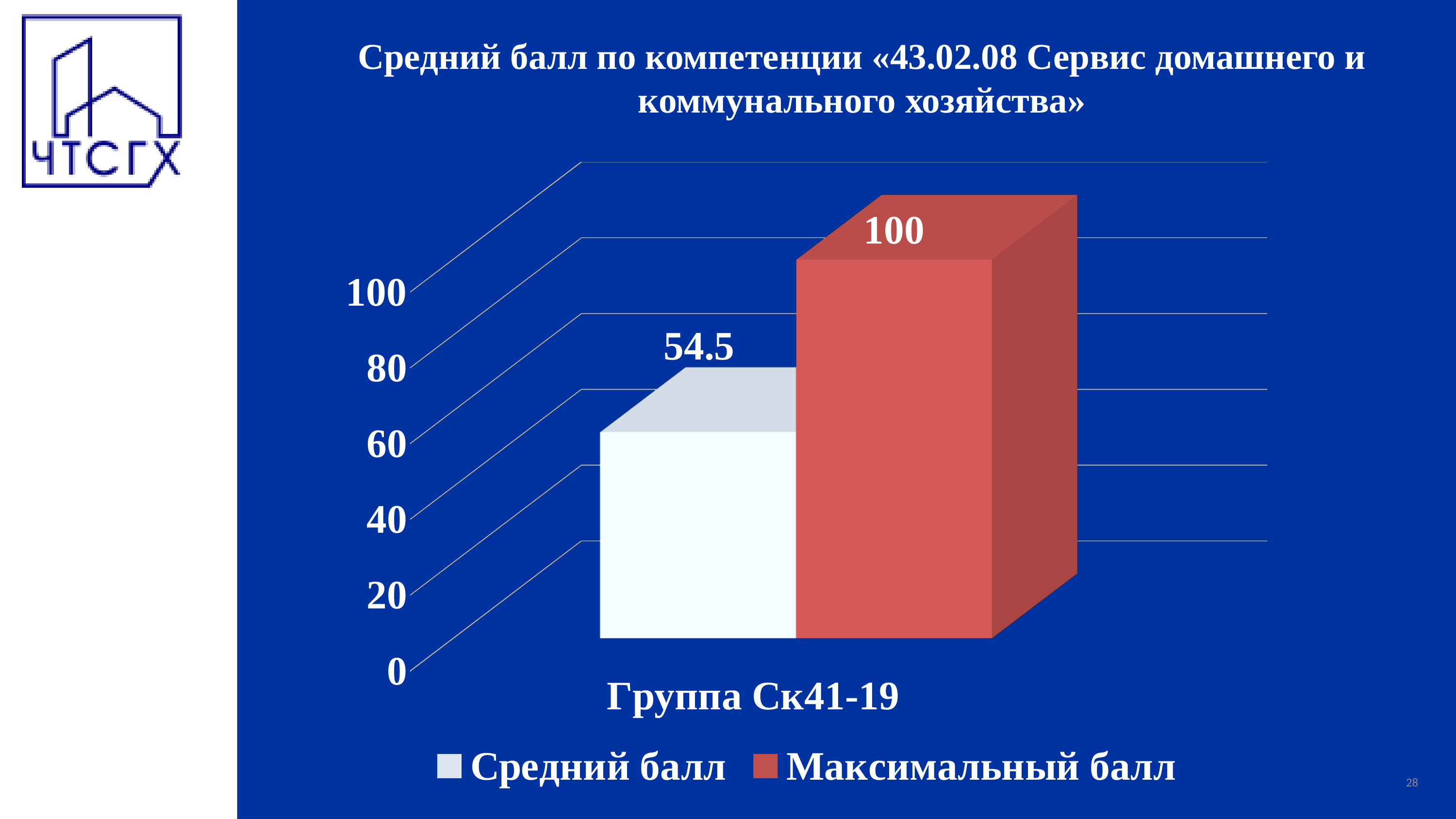
Which series is shown in red in the legend? Максимальный балл What is the value of Средний балл for Группа Ск41-19? 54.5 What is the difference between Максимальный балл and Средний балл for Группа Ск41-19? 45.5 How many series does the legend list? 2 Is the value of Средний балл for Группа Ск41-19 greater or less than 60? less Which series has the lowest value on the chart? Средний балл What is the value of Максимальный балл for Группа Ск41-19? 100 Is the value of Средний балл for Группа Ск41-19 greater or less than 40? greater Which series has the higher value for Группа Ск41-19, Средний балл or Максимальный балл? Максимальный балл What is the name of the category shown on the x axis? Группа Ск41-19 What kind of chart is shown on the slide? bar chart How many categories are shown on the x axis? 1